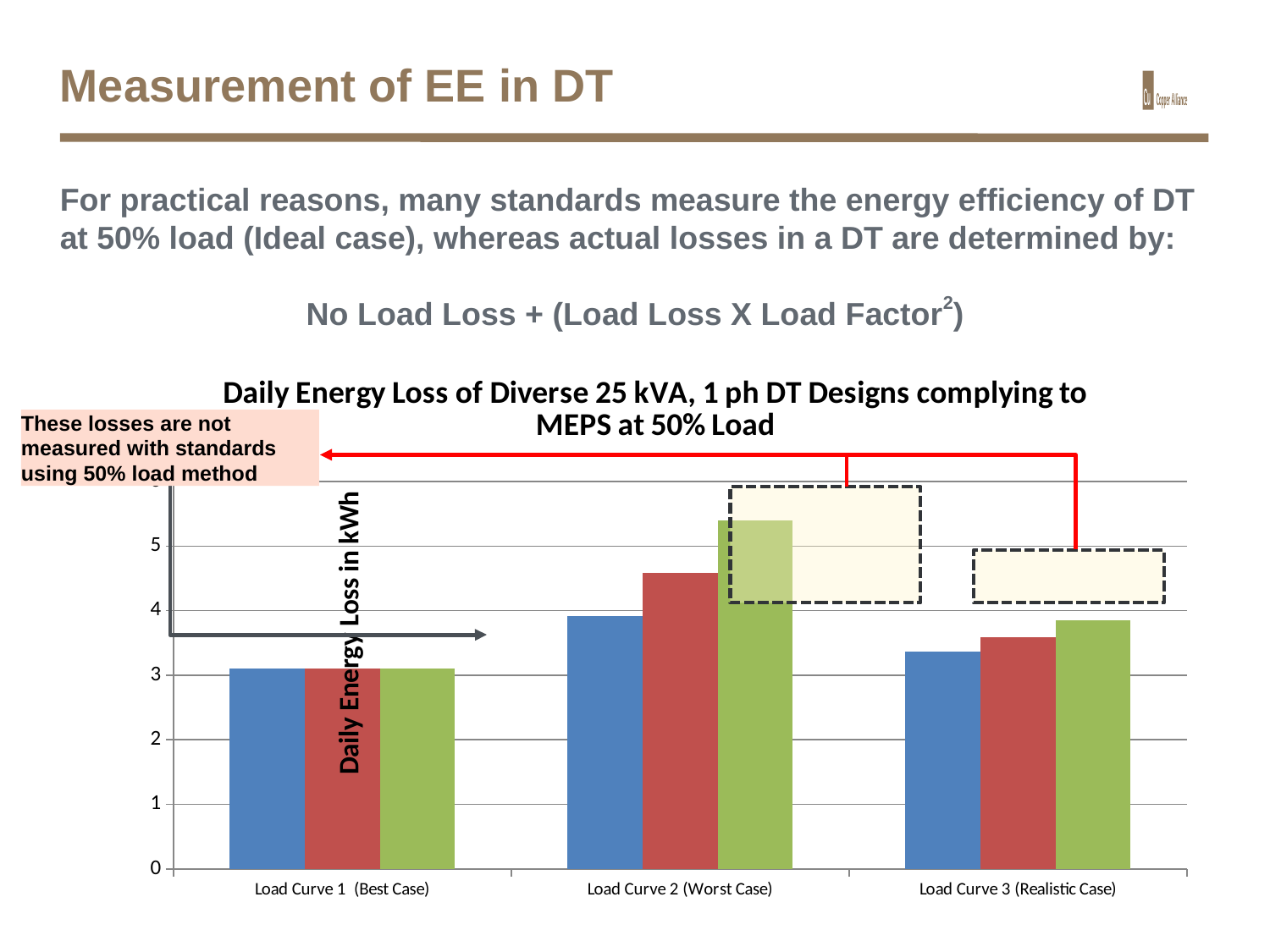
How many categories are shown on the x axis of the chart? 3 Is the value of the blue bar for Load Curve 2 (Worst Case) greater or less than 4? less Is the value of the red bar for Load Curve 2 (Worst Case) greater or less than 4? greater What kind of chart is shown on the slide? bar chart What is the title of the chart? Daily Energy Loss of Diverse 25 kVA, 1 ph DT Designs complying to MEPS at 50% Load How many bars are plotted for each load curve category? 3 Is the value of the green bar for Load Curve 2 (Worst Case) greater or less than 5? greater Which category contains the tallest bar in the chart? Load Curve 2 (Worst Case) What is the label of the vertical axis of the chart? Daily Energy Loss in kWh Which is larger: the green bar for Load Curve 2 (Worst Case) or the green bar for Load Curve 3 (Realistic Case)? Load Curve 2 (Worst Case) Which category has the lowest bars in the chart? Load Curve 1 (Best Case)